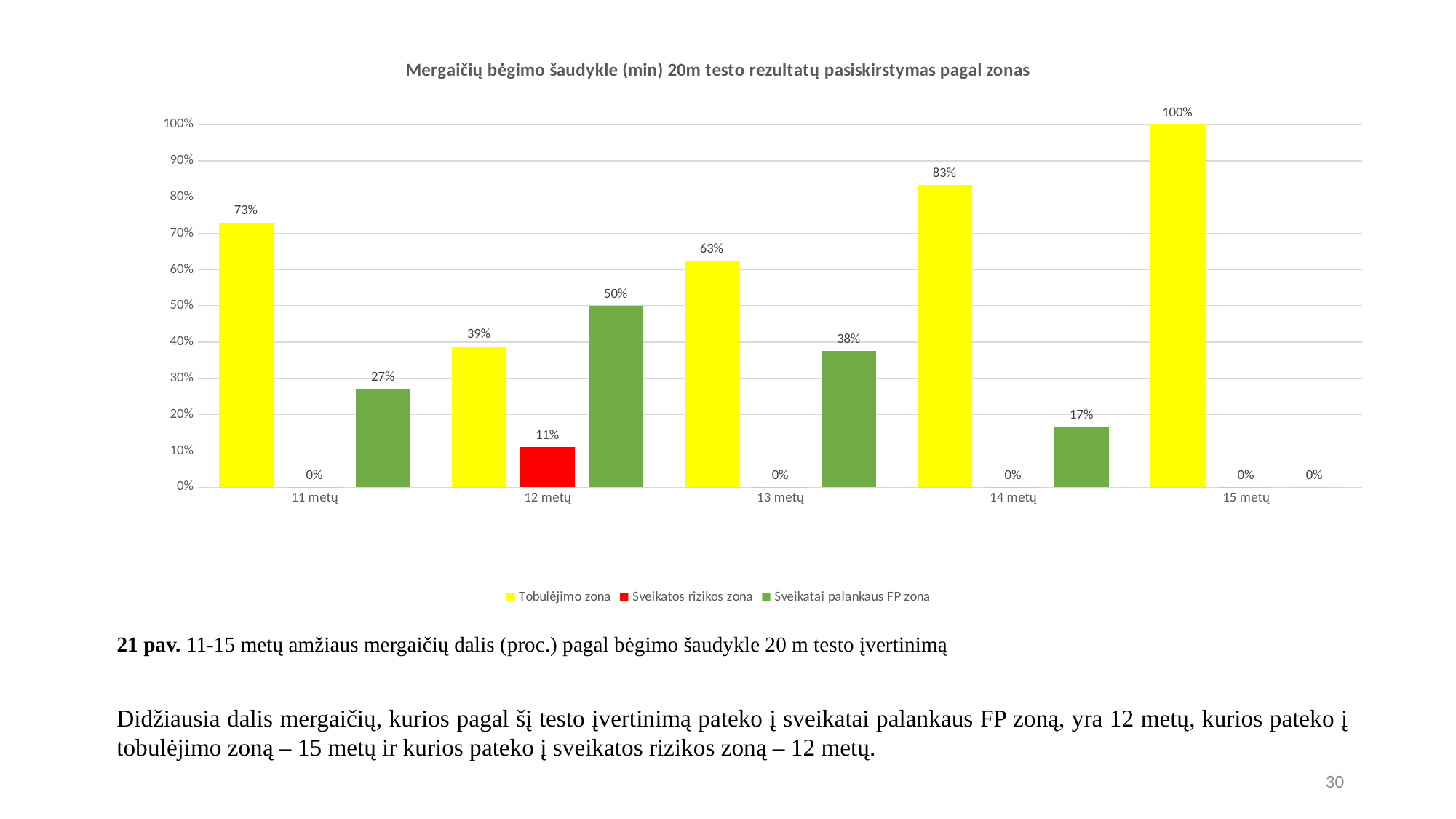
How many age groups are shown on the x axis? 5 What is the difference between Tobulėjimo zona for 14 metų and Tobulėjimo zona for 13 metų? 20% Which age group has the highest value for Tobulėjimo zona? 15 metų Which is larger: Sveikatai palankaus FP zona for 11 metų or Sveikatai palankaus FP zona for 14 metų? 11 metų How many series does the legend list? 3 What type of chart is shown on the slide? bar chart Which age group has the lowest value for Tobulėjimo zona? 12 metų What is the value of Sveikatos rizikos zona for 12 metų? 11% What is the value of Tobulėjimo zona for 11 metų? 73% What is the value of Sveikatai palankaus FP zona for 13 metų? 38% Which colour represents Sveikatos rizikos zona in the chart? red Which age group has the highest value for Sveikatai palankaus FP zona? 12 metų